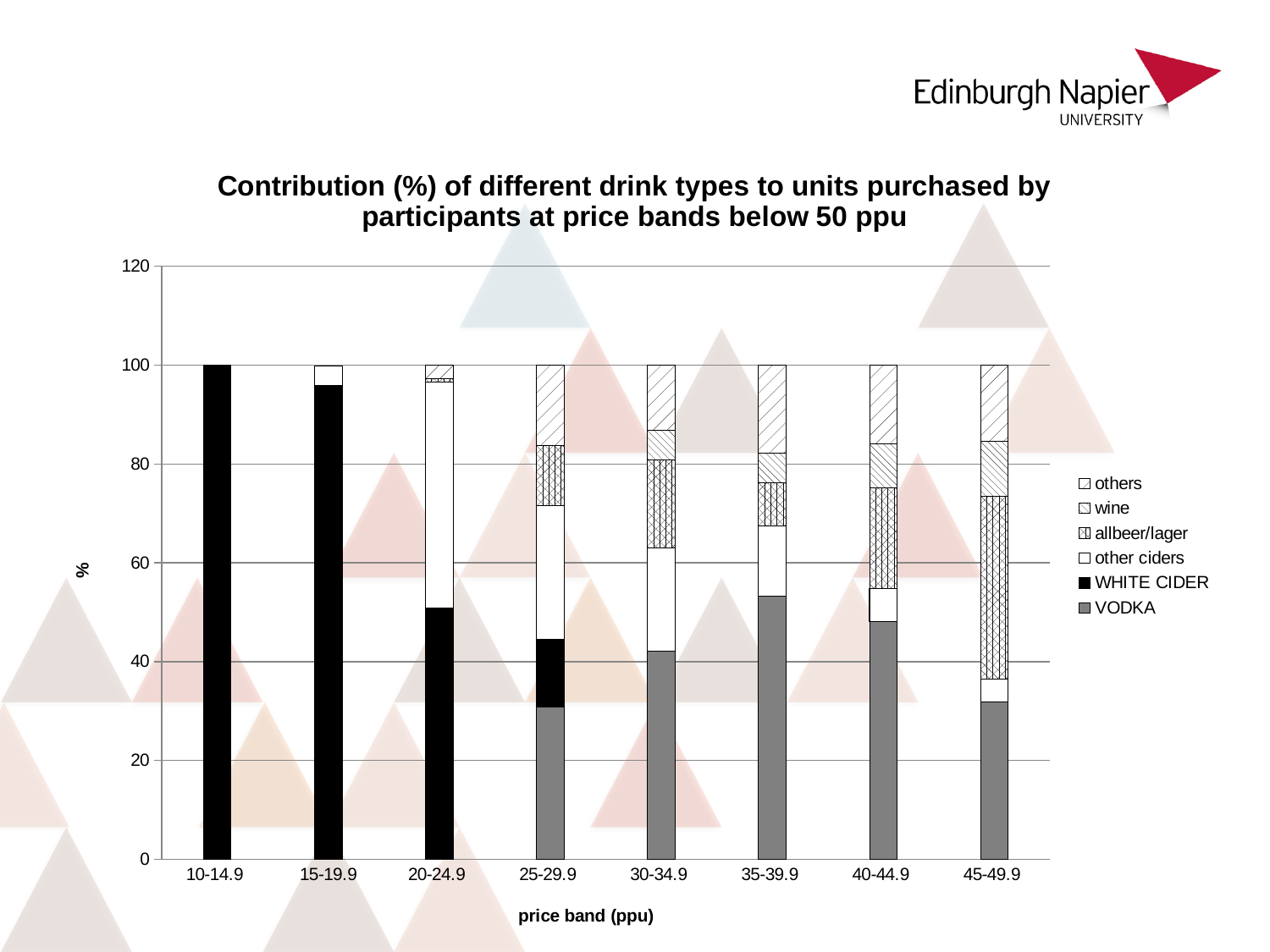
Is the VODKA contribution for the 35-39.9 price band greater or less than 40? greater Is the WHITE CIDER contribution for the 20-24.9 price band greater or less than 60? less Which drink type makes up the entire bar for the 10-14.9 price band? WHITE CIDER Does the WHITE CIDER contribution rise or fall as the price band increases? fall Which price band has the largest WHITE CIDER contribution? 10-14.9 How many drink types does the legend list? 6 How many price bands are shown on the x axis? 8 What is the label of the x axis? price band (ppu) Is the VODKA contribution for the 45-49.9 price band greater or less than 40? less What is the WHITE CIDER contribution for the 10-14.9 price band? 100 What kind of chart is shown on the slide? stacked bar chart Which price band has the larger VODKA contribution, 35-39.9 or 45-49.9? 35-39.9